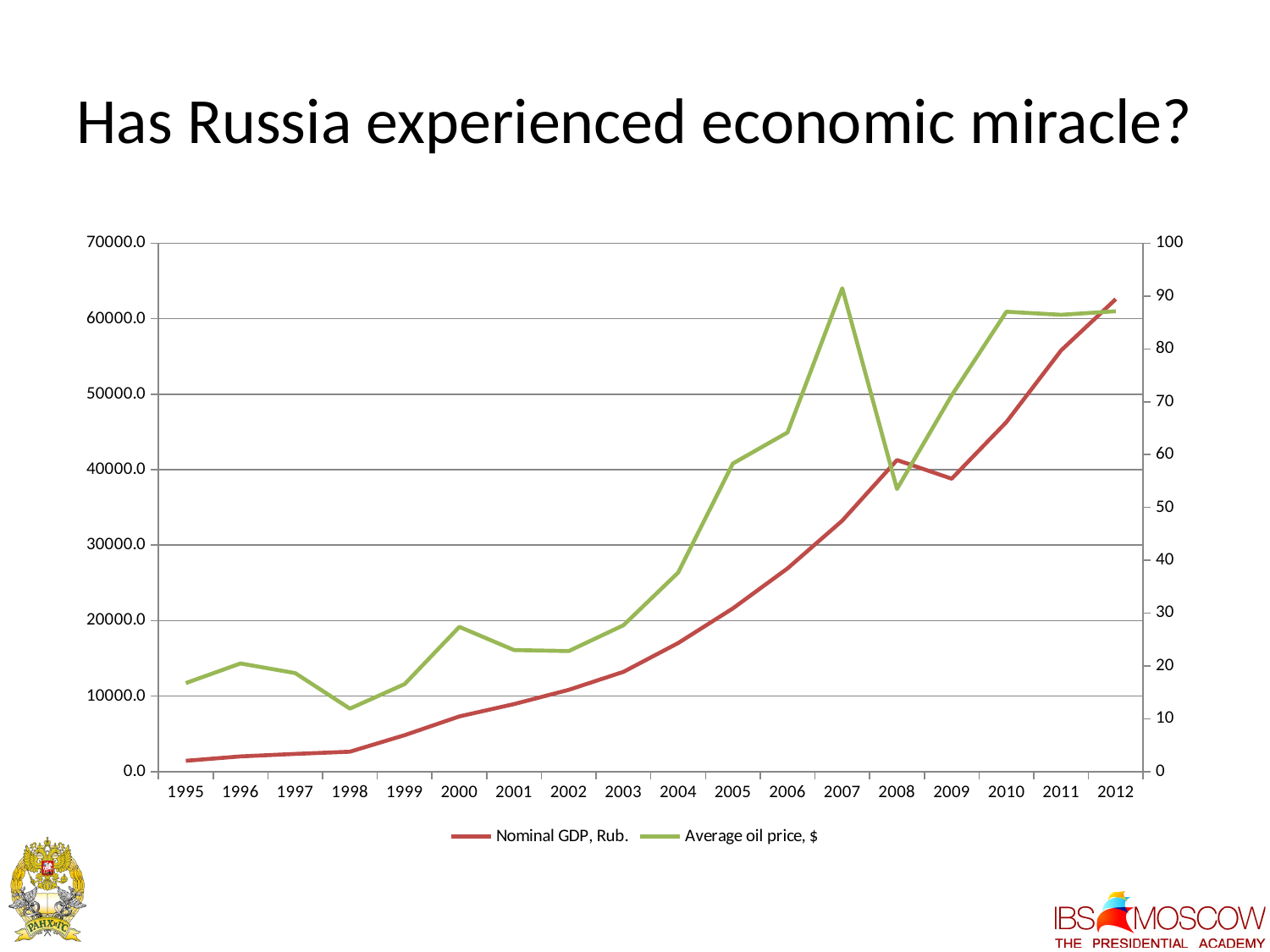
Is the value for Average oil price, $ in 2010 greater or less than 80? greater Is the value for Nominal GDP, Rub. in 2000 greater or less than 10000.0? less Which year has the higher Average oil price, $: 2007 or 2008? 2007 What kind of chart is shown on the slide? Line chart Is the value for Nominal GDP, Rub. in 2012 greater or less than 60000.0? greater How many years are plotted along the x axis? 18 How many series does the legend list? 2 In which year is Nominal GDP, Rub. at its highest? 2012 Does Nominal GDP, Rub. generally rise or fall from 1995 to 2012? Rise In which year is the Average oil price, $ at its lowest? 1998 In which year is the Average oil price, $ at its highest? 2007